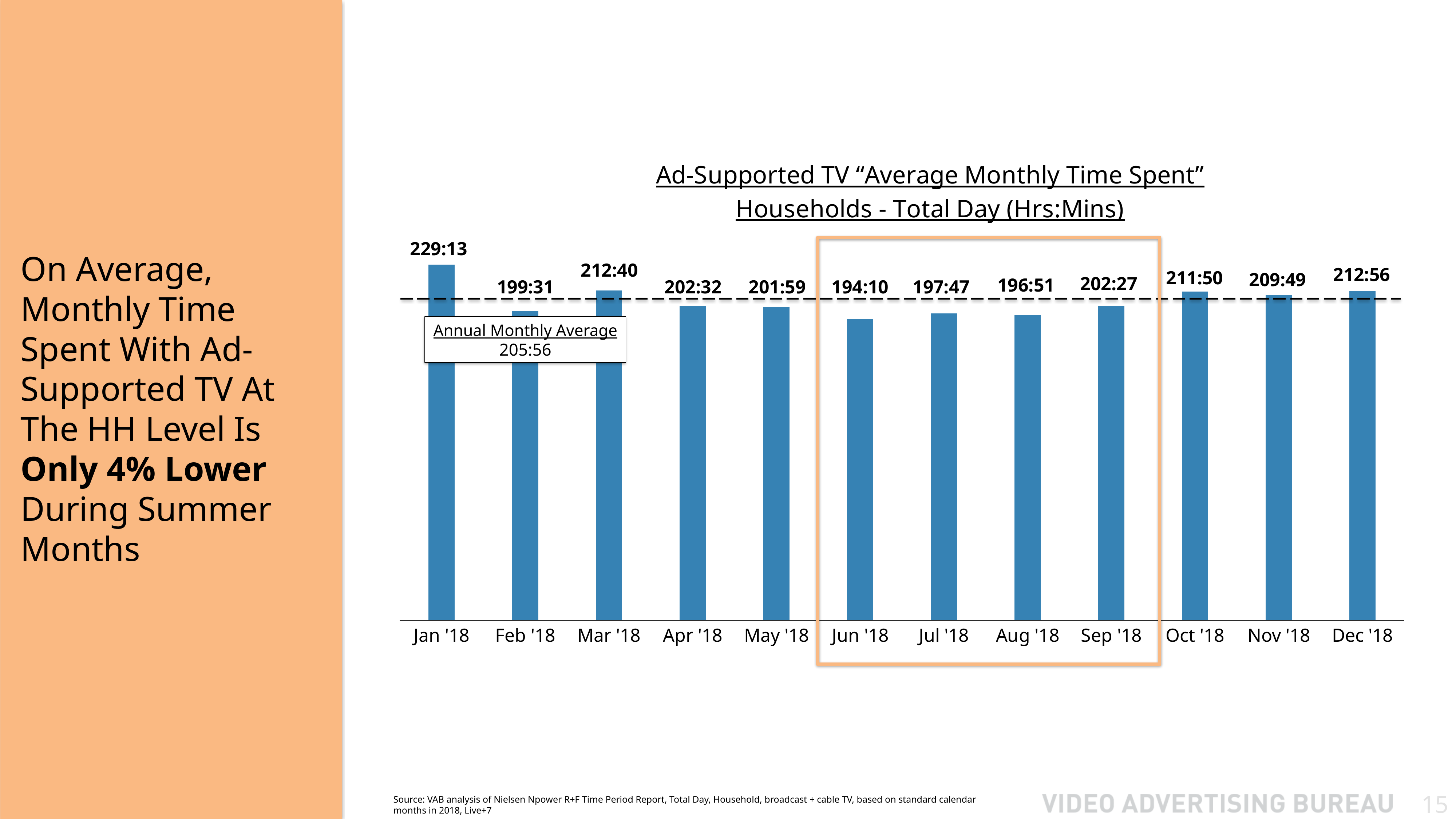
What is the difference between the values for Dec '18 and Nov '18? 3:07 What is the value for Aug '18? 196:51 What is the Annual Monthly Average shown by the dashed line? 205:56 What is the difference between the values for Jan '18 and Jun '18? 35:03 Which month has the highest average monthly time spent? Jan '18 What kind of chart is shown on the slide? Bar chart Which is larger, the value for Feb '18 or the value for Sep '18? Sep '18 Which is larger, the value for Mar '18 or the value for Oct '18? Mar '18 What is the value for Dec '18? 212:56 Which month has the lowest average monthly time spent? Jun '18 How many months are shown on the chart? 12 What is the value for Jan '18? 229:13